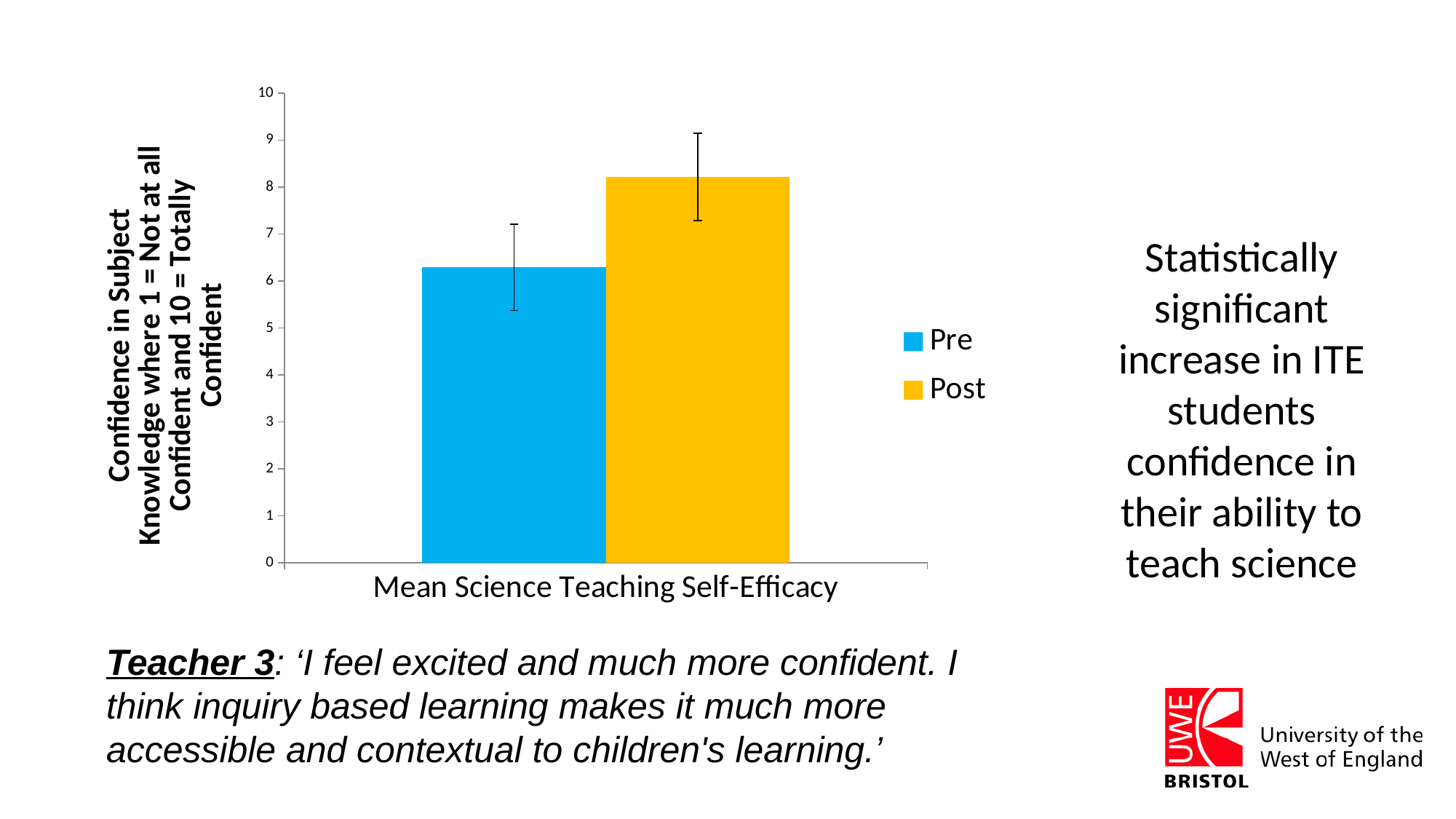
Is the value for Post greater or less than 9? less What is the category label on the x axis of the chart? Mean Science Teaching Self-Efficacy Which series has the lowest bar in the chart? Pre How many series does the chart's legend list? 2 What kind of chart is shown on the slide? bar chart Is the value for Pre greater or less than 6? greater Which series has the highest bar in the chart? Post How many categories are shown on the x axis of the chart? 1 Which series has the higher bar, Pre or Post? Post What are the two series named in the chart's legend? Pre and Post Is the value for Pre greater or less than 7? less